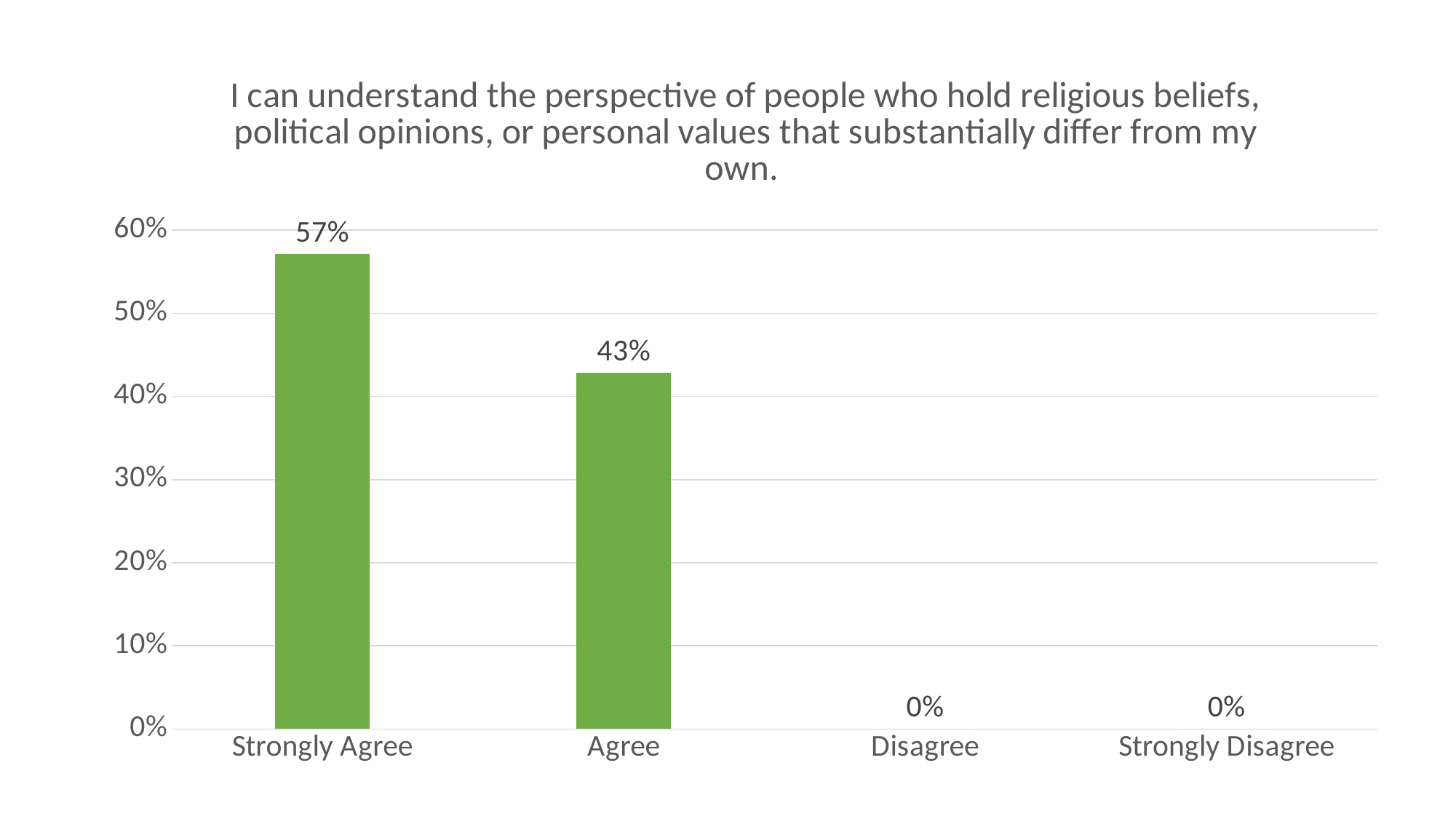
What is the value for Disagree? 0% Which category has the highest value? Strongly Agree What is the difference between the values for Strongly Agree and Agree? 14% Is the value for Strongly Agree greater or less than 50%? greater What is the value for Agree? 43% How many categories are shown on the x axis? 4 What is the value for Strongly Agree? 57% What is the value for Strongly Disagree? 0% Is the value for Agree greater or less than 50%? less Which is larger, the value for Strongly Agree or the value for Agree? Strongly Agree What is the total of the values for Strongly Agree and Agree? 100% What kind of chart is this? bar chart